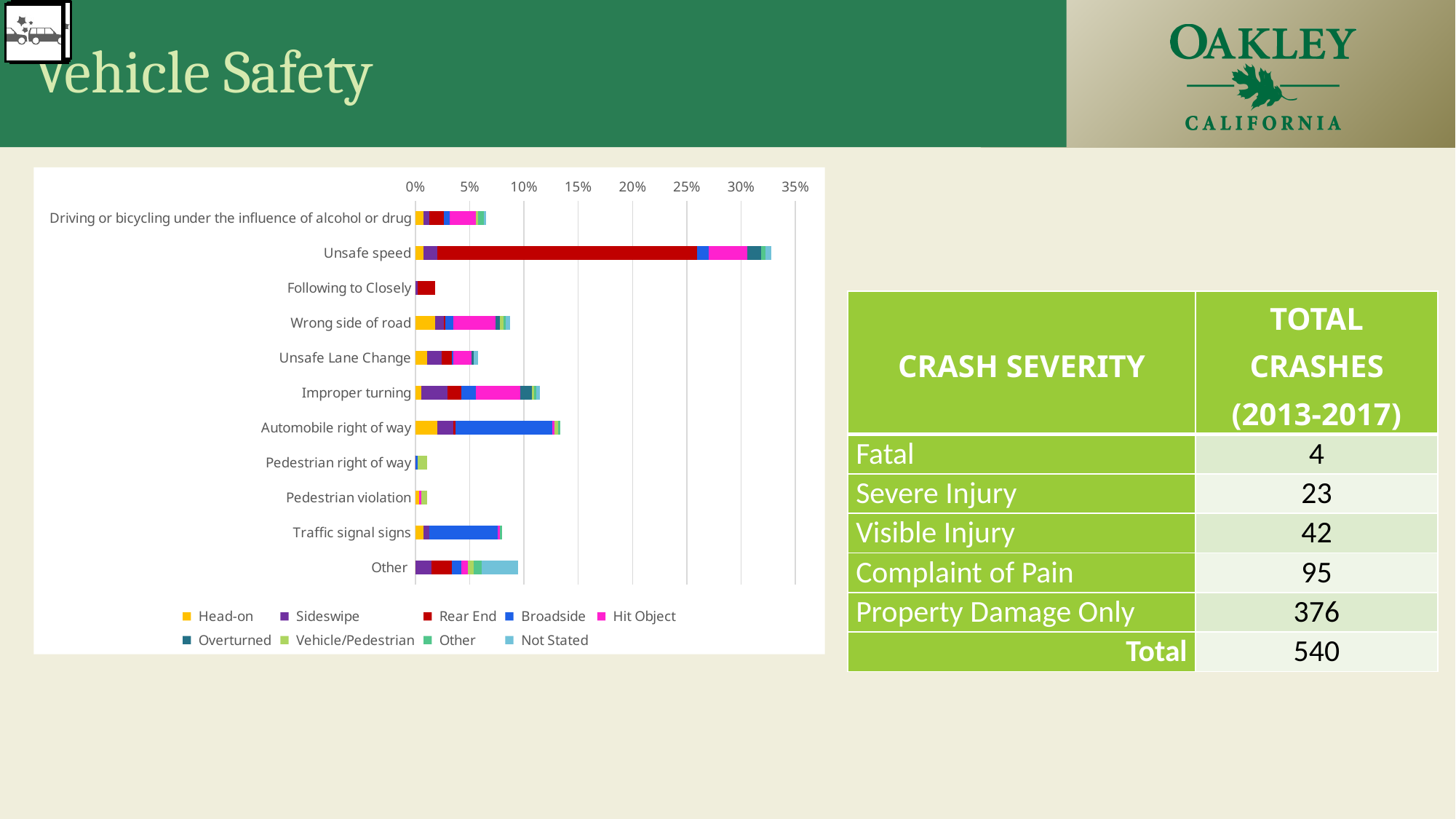
How many series does the chart's legend list? 9 How many collision-factor categories are listed on the chart's vertical axis? 11 Is the total bar for Automobile right of way greater or less than 10%? greater Which has the longer bar, Automobile right of way or Traffic signal signs? Automobile right of way Which series makes up most of the Unsafe speed bar? Rear End Is the total bar for Traffic signal signs greater or less than 10%? less What kind of chart is shown on the slide? Stacked bar chart Is the total bar for Following to Closely greater or less than 5%? less Which category has the longest bar in the chart? Unsafe speed Which has the longer bar, Improper turning or Unsafe Lane Change? Improper turning What colour represents the Broadside series in the legend? Blue